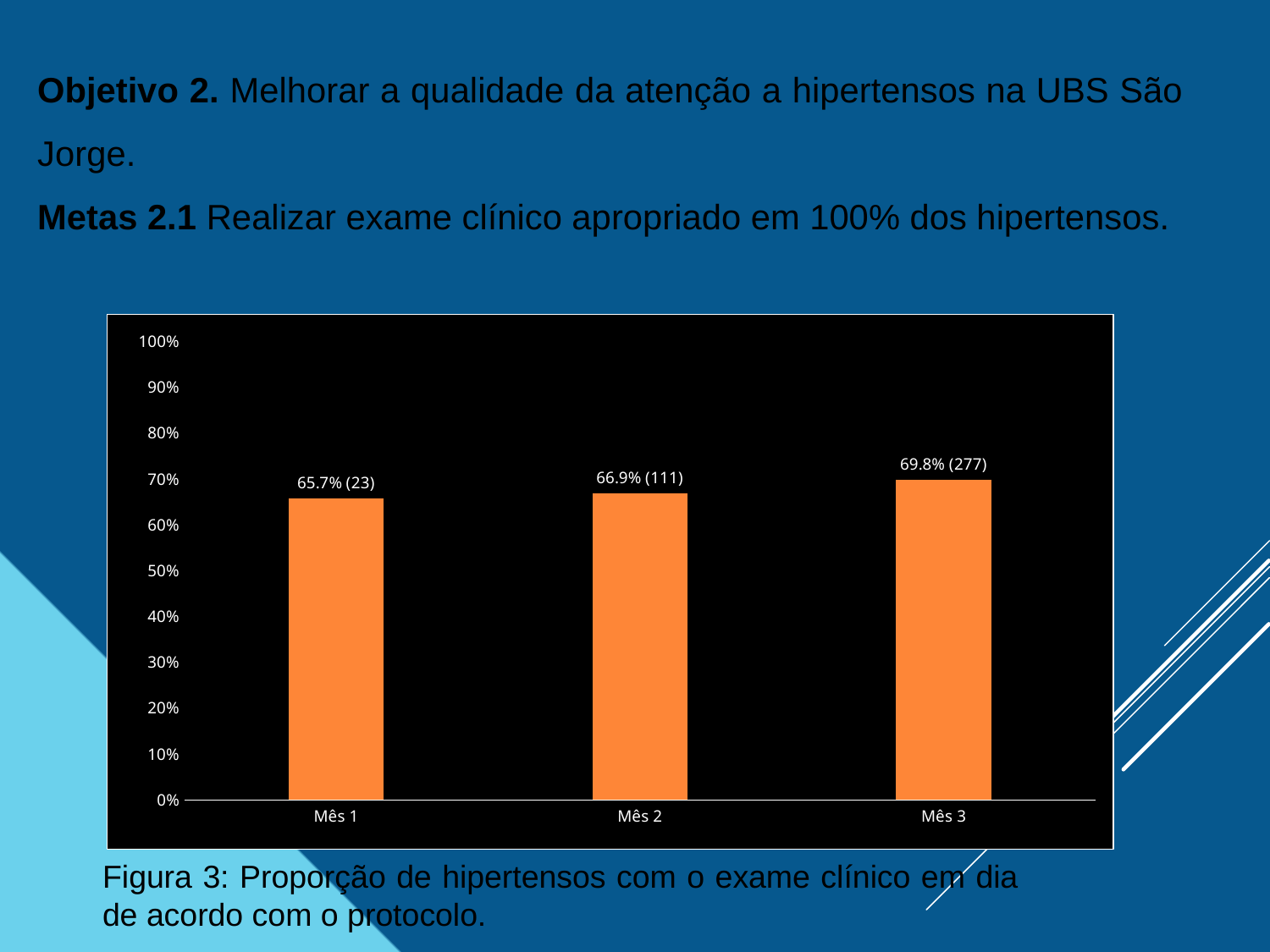
Do the values rise or fall from Mês 1 to Mês 3? Rise What kind of chart is shown on the slide? Bar chart Which month has the highest proportion? Mês 3 What is the value shown for Mês 1? 65.7% (23) Is the value for Mês 3 greater or less than 80%? less What is the value shown for Mês 2? 66.9% (111) What colour are the bars in the chart? Orange Which month has the lowest proportion? Mês 1 What is the value shown for Mês 3? 69.8% (277) What is the difference in percentage points between Mês 3 and Mês 1? 4.1 Which is larger, the value for Mês 2 or the value for Mês 1? Mês 2 How many months are shown on the x axis? 3